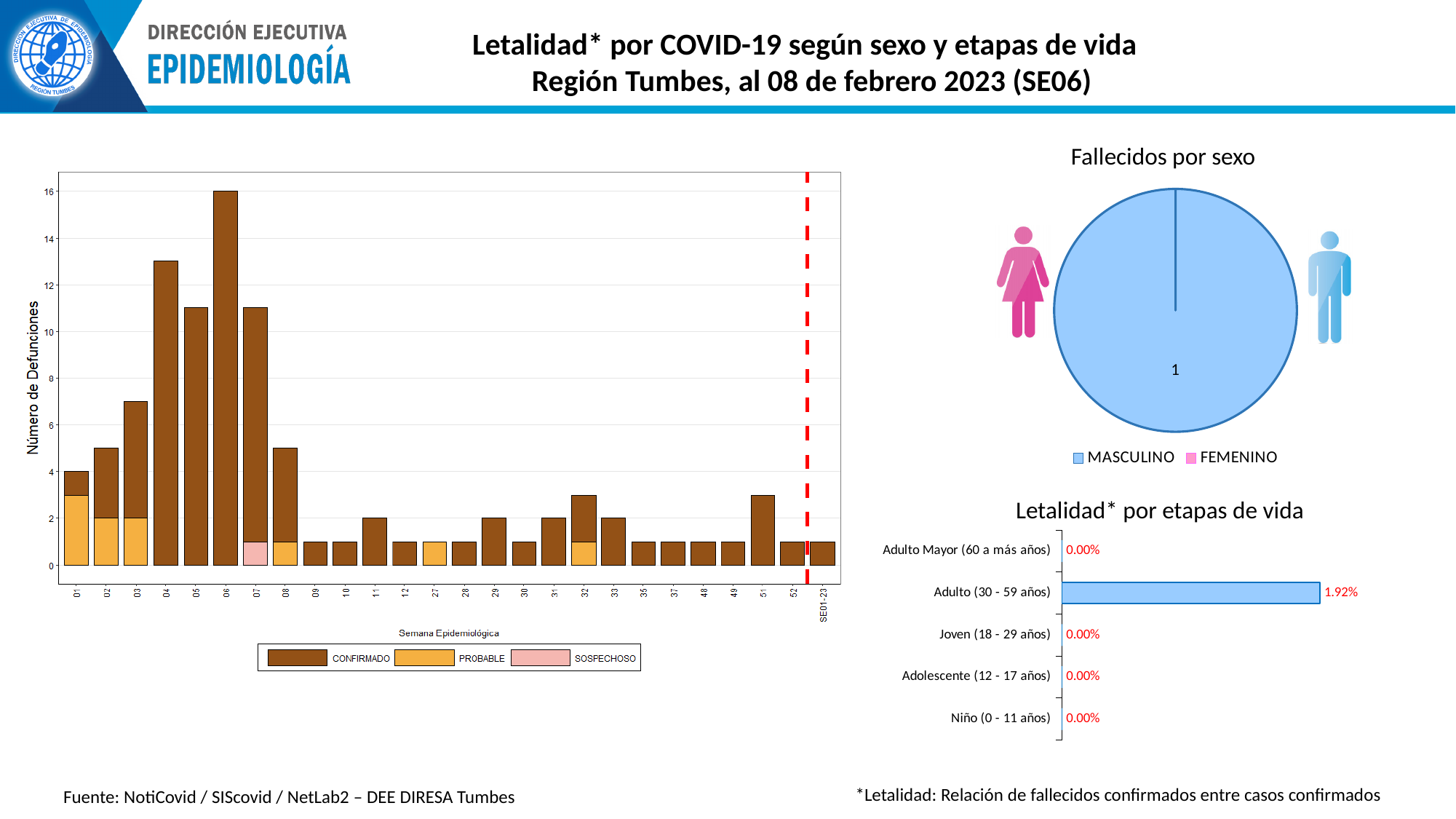
In the left bar chart of deaths by epidemiological week, how many deaths are shown for week 06? 16 How many age groups are shown in the 'Letalidad* por etapas de vida' chart? 5 What type of chart is the 'Fallecidos por sexo' chart? pie chart In the 'Letalidad* por etapas de vida' chart, which age group has the highest value? Adulto (30 - 59 años) In the 'Fallecidos por sexo' chart, what value is shown for MASCULINO? 1 In the left bar chart of deaths by epidemiological week, which week has the highest number of deaths? 06 How many entries does the legend of the 'Fallecidos por sexo' chart list? 2 What type of chart is the 'Letalidad* por etapas de vida' chart? bar chart In the 'Letalidad* por etapas de vida' chart, what is the value for Adulto (30 - 59 años)? 1.92% In the left bar chart of deaths by epidemiological week, is the total for week 04 greater or less than 12? greater How many series does the legend of the left bar chart of deaths by epidemiological week list? 3 In the 'Letalidad* por etapas de vida' chart, what is the value for Adulto Mayor (60 a más años)? 0.00%